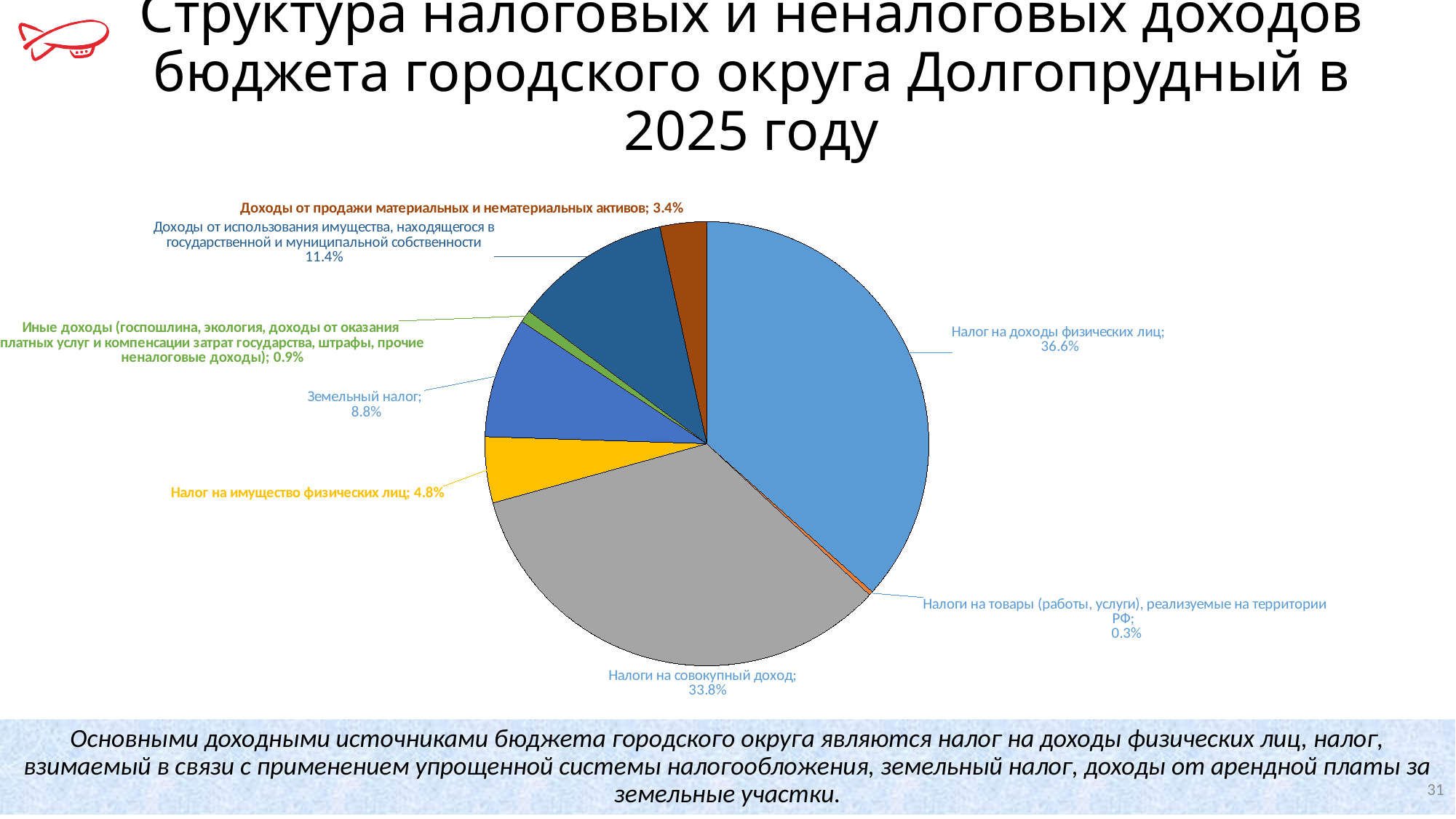
How many slices does the pie chart have? 8 Which category has the largest share of the pie? Налог на доходы физических лиц Which category has the smallest share of the pie? Налоги на товары (работы, услуги), реализуемые на территории РФ What share of the pie does "Налог на доходы физических лиц" have? 36.6% Which is larger: the share of "Земельный налог" or the share of "Налог на имущество физических лиц"? Земельный налог What share of the pie does "Налоги на совокупный доход" have? 33.8% What is the value shown for "Налоги на товары (работы, услуги), реализуемые на территории РФ"? 0.3% What type of chart is shown on the slide? Pie chart What is the value shown for "Доходы от использования имущества, находящегося в государственной и муниципальной собственности"? 11.4% What is the value shown for "Земельный налог"? 8.8% What is the combined share of "Доходы от продажи материальных и нематериальных активов" and "Иные доходы (госпошлина, экология, доходы от оказания платных услуг и компенсации затрат государства, штрафы, прочие неналоговые доходы)"? 4.3% What is the difference between the shares of "Налог на доходы физических лиц" and "Налоги на совокупный доход"? 2.8%